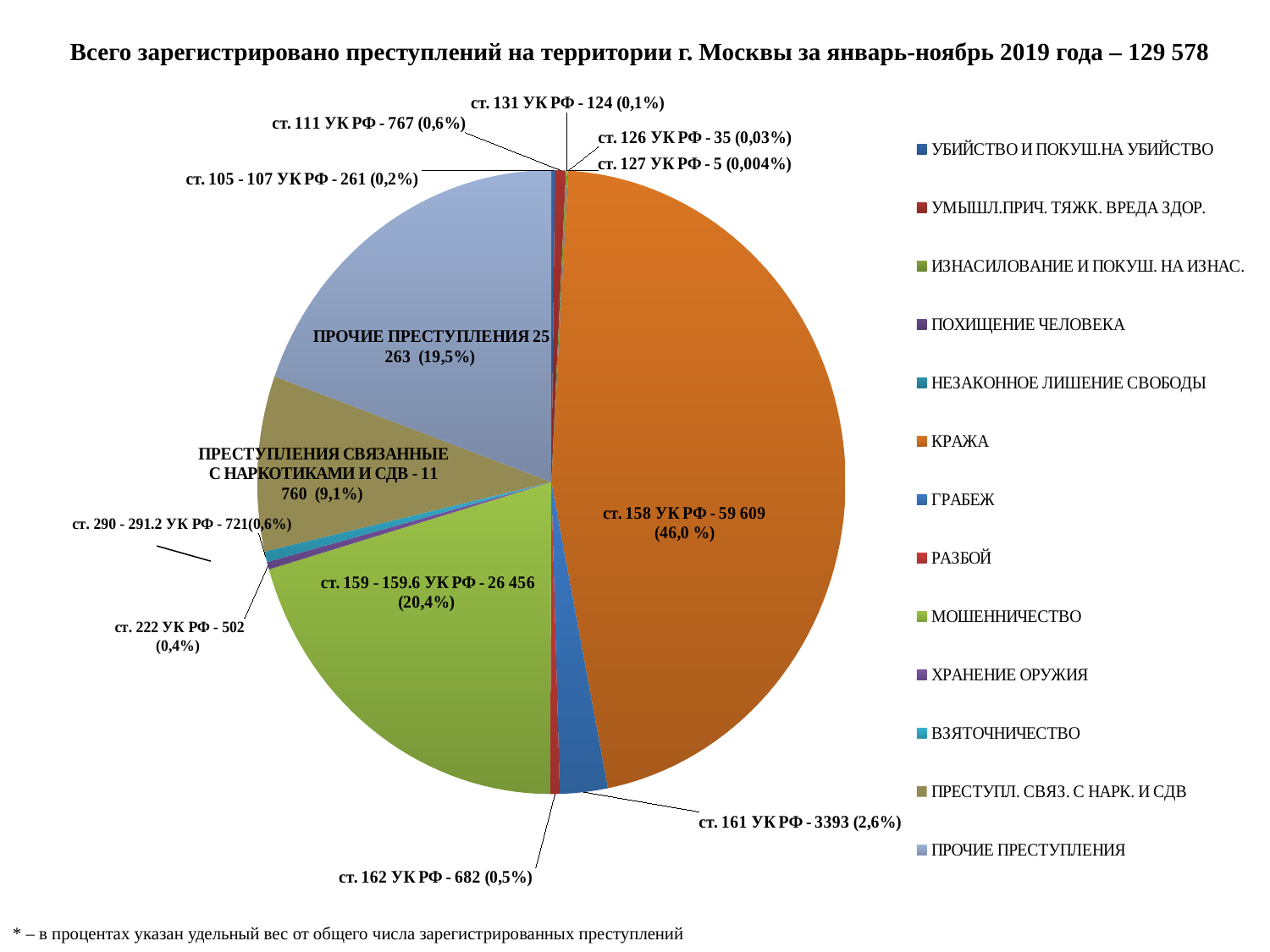
What is the difference between the values for ст. 158 УК РФ and ст. 159 - 159.6 УК РФ? 33 153 What share of the pie does ПРЕСТУПЛЕНИЯ СВЯЗАННЫЕ С НАРКОТИКАМИ И СДВ account for? 9,1% What total number of registered crimes is stated in the chart title? 129 578 What is the number of crimes shown for ПРОЧИЕ ПРЕСТУПЛЕНИЯ? 25 263 How many entries does the legend list? 13 What kind of chart is shown on the slide? pie chart Which is larger, the value for ст. 111 УК РФ or the value for ст. 162 УК РФ? ст. 111 УК РФ What is the number of crimes shown for ст. 161 УК РФ? 3393 Which category has the largest slice of the pie? ст. 158 УК РФ (КРАЖА) What share of the pie does ст. 159 - 159.6 УК РФ account for? 20,4% Which category has the smallest slice of the pie? ст. 127 УК РФ What is the number of crimes shown for ст. 158 УК РФ? 59 609